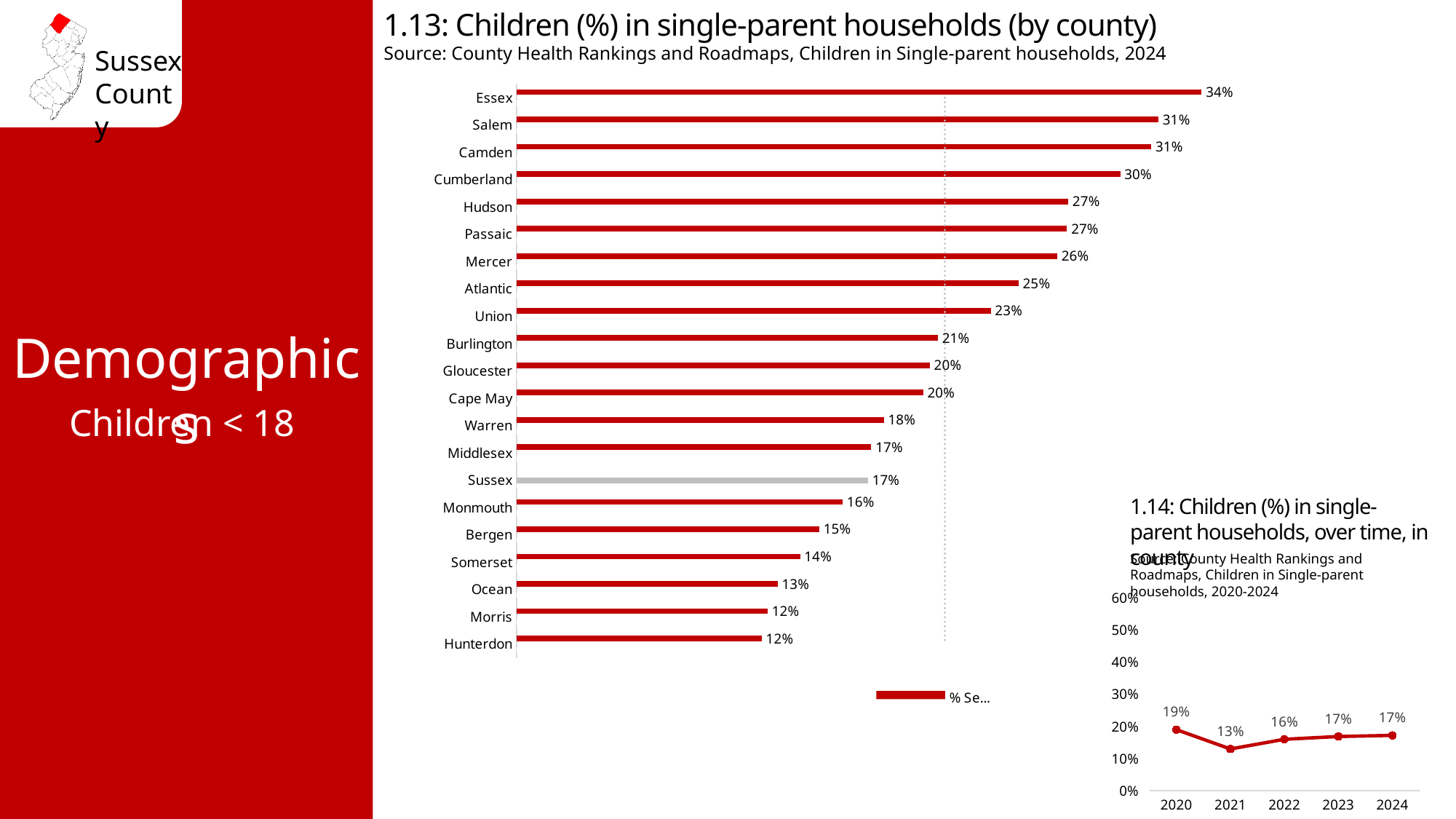
In chart 1.13 (Children in single-parent households by county), what is the value for Sussex? 17% In chart 1.13 (by county), what is the value for Hudson? 27% In chart 1.13 (by county), what is the difference between Essex and Hunterdon? 22 percentage points What kind of chart is chart 1.13 (Children in single-parent households by county)? Bar chart In chart 1.13 (by county), which is larger, the value for Union or the value for Bergen? Union In chart 1.13 (by county), which bar is coloured grey instead of red? Sussex In chart 1.14 (over time, in county), how many years are plotted? 5 In chart 1.13 (by county), which county has the highest percentage of children in single-parent households? Essex In chart 1.13 (by county), how many counties are shown? 21 In chart 1.14 (over time, in county), which year has the highest value? 2020 In chart 1.14 (over time, in county), what is the difference between the 2020 value and the 2021 value? 6 percentage points In chart 1.14 (over time, in county), what is the value for 2021? 13%